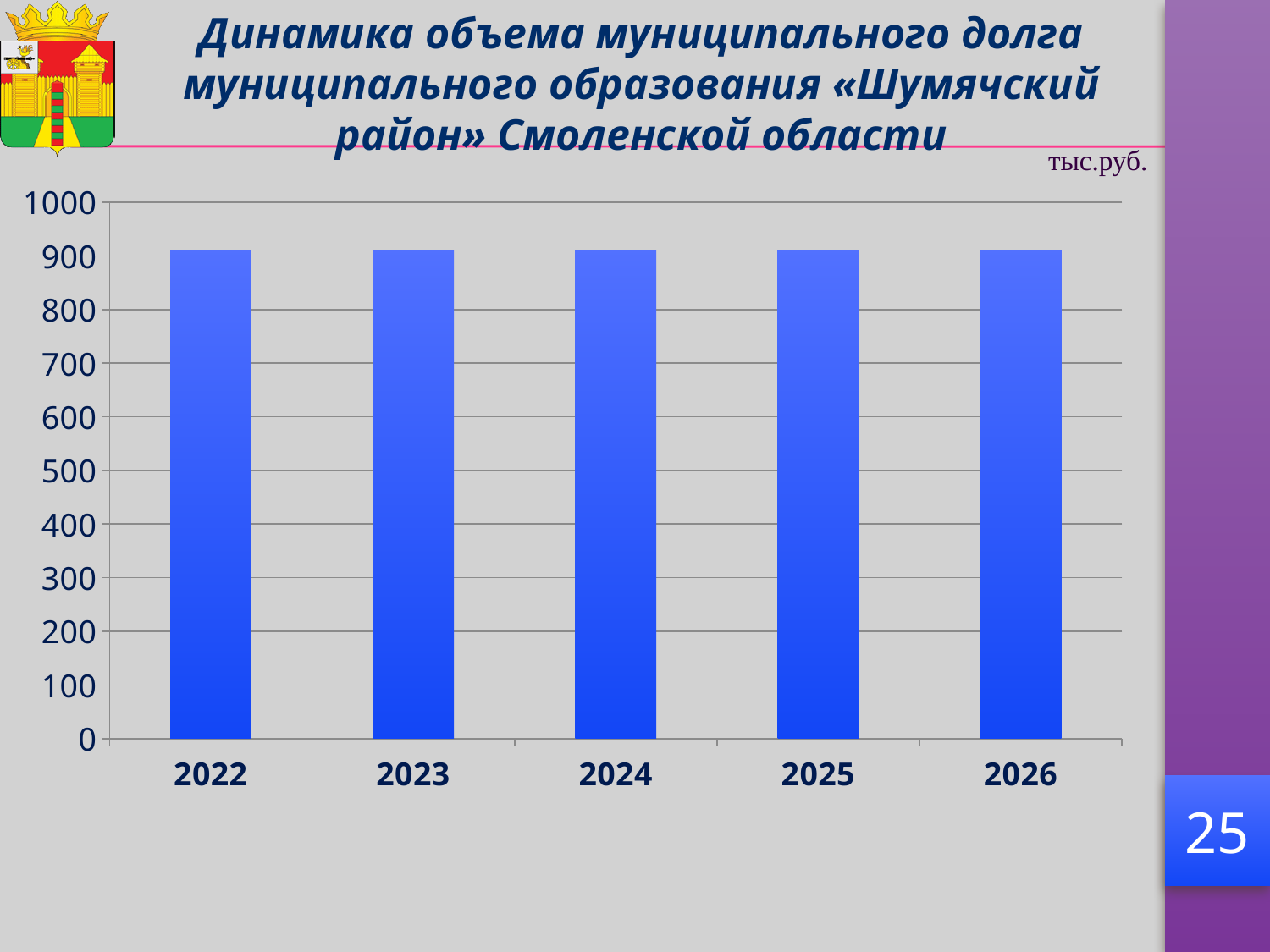
Do the values rise, fall or stay flat from 2022 to 2026? stay flat What is the first year shown on the x axis? 2022 Is the value for 2025 greater or less than 1000? less How many years are shown on the x axis of the chart? 5 What kind of chart is shown on the slide? bar chart Is the value for 2024 greater or less than 1000? less Is the value for 2022 greater or less than 800? greater What unit of measurement is indicated above the chart? тыс.руб.